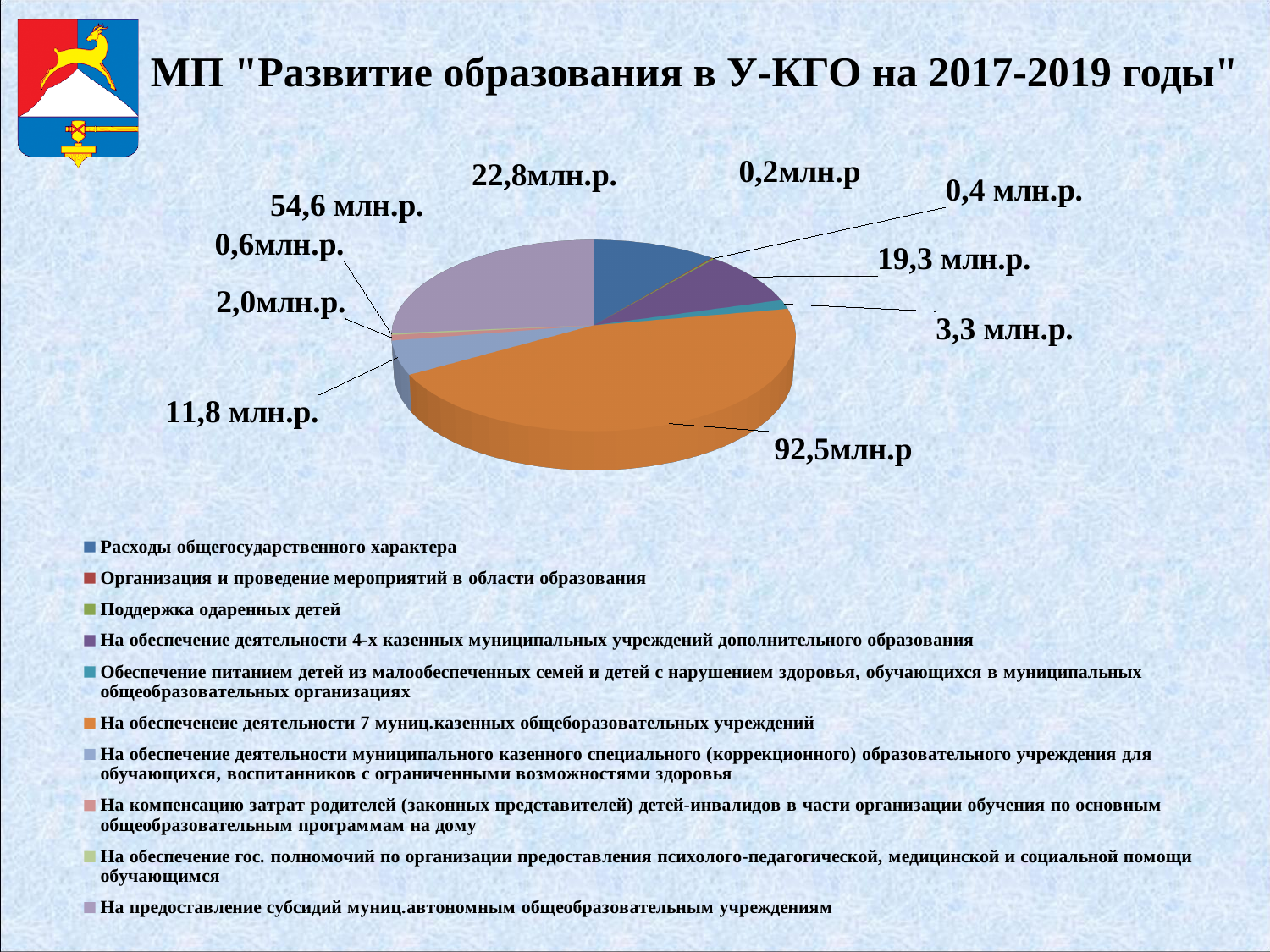
What is the value for 'На обеспечение деятельности 4-х казенных муниципальных учреждений дополнительного образования'? 19,3 млн.р. What is the value for 'На предоставление субсидий муниц.автономным общеобразовательным учреждениям'? 54,6 млн.р. Which category has the largest slice of the pie? На обеспеченеие деятельности 7 муниц.казенных общеборазовательных учреждений What is the value of the largest slice of the pie? 92,5млн.р What is the difference between the largest slice (92,5 млн.р.) and the second largest slice (54,6 млн.р.)? 37,9 млн.р. Which is larger: the slice labelled 19,3 млн.р. or the slice labelled 22,8 млн.р.? 22,8млн.р. What is the title of the slide? МП "Развитие образования в У-КГО на 2017-2019 годы" What is the difference between the slices labelled 11,8 млн.р. and 3,3 млн.р.? 8,5 млн.р. What is the smallest value labelled on the pie chart? 0,2млн.р What kind of chart is shown on the slide? pie chart What is the value for 'Расходы общегосударственного характера'? 22,8млн.р. How many categories does the legend list? 10